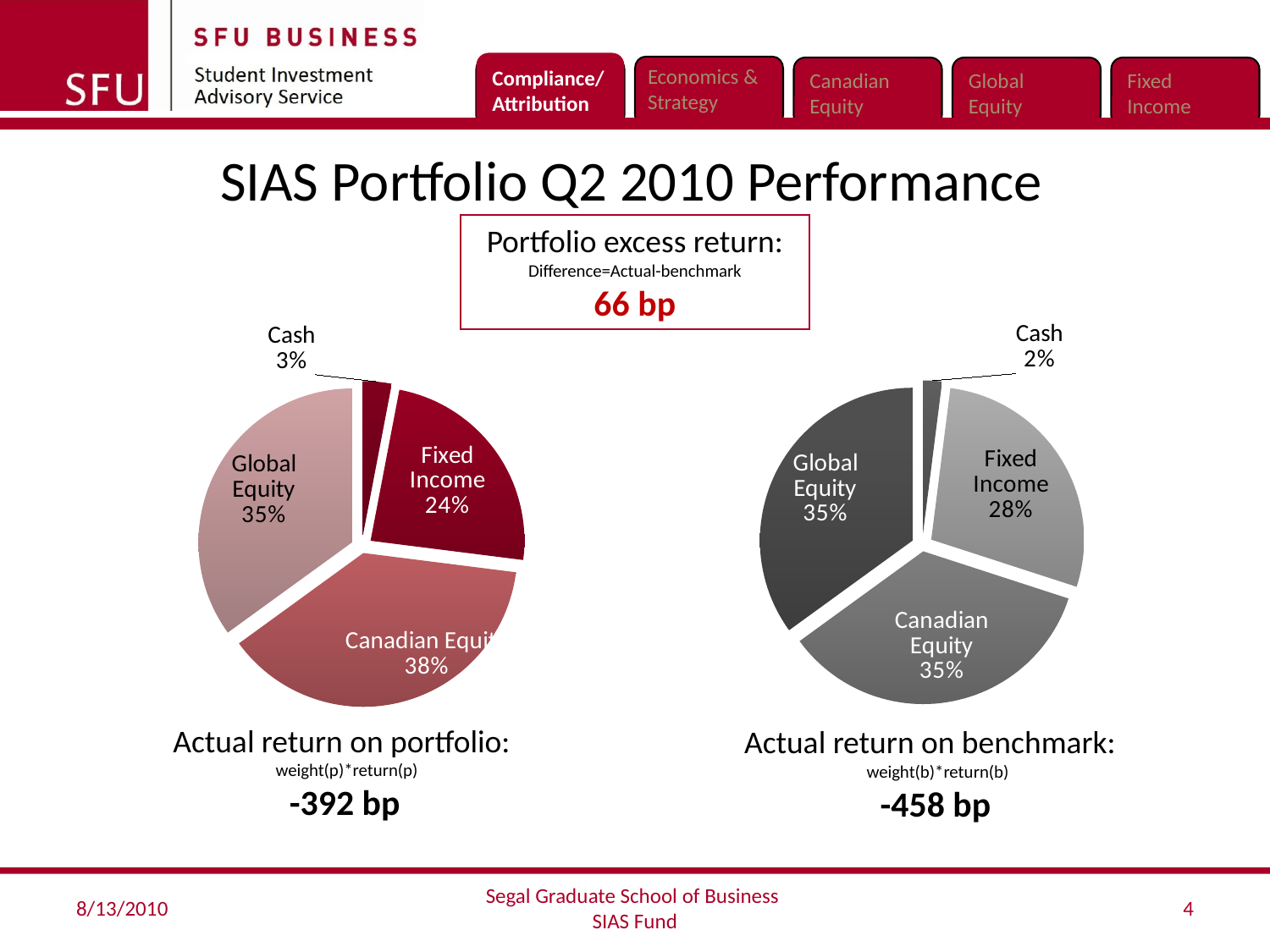
What type of chart is used on the right side of the slide for the benchmark? Pie chart In the right pie chart (benchmark), what share does Global Equity have? 35% What is the difference between the Fixed Income share in the right pie chart (benchmark) and the Fixed Income share in the left pie chart (portfolio)? 4% In the right pie chart (benchmark), what share does Fixed Income have? 28% In the left pie chart (actual portfolio), what share does Canadian Equity have? 38% How many categories are shown in the left pie chart (actual portfolio)? 4 In the left pie chart (actual portfolio), what is the combined share of Global Equity and Canadian Equity? 73% In the left pie chart (actual portfolio), which category has the largest slice? Canadian Equity Which is larger: the Canadian Equity share in the left pie chart (portfolio) or the Canadian Equity share in the right pie chart (benchmark)? Left pie chart (portfolio) What is the caption printed below the right pie chart? Actual return on benchmark: In the right pie chart (benchmark), which category has the smallest slice? Cash In the left pie chart (actual portfolio), what share does Cash have? 3%